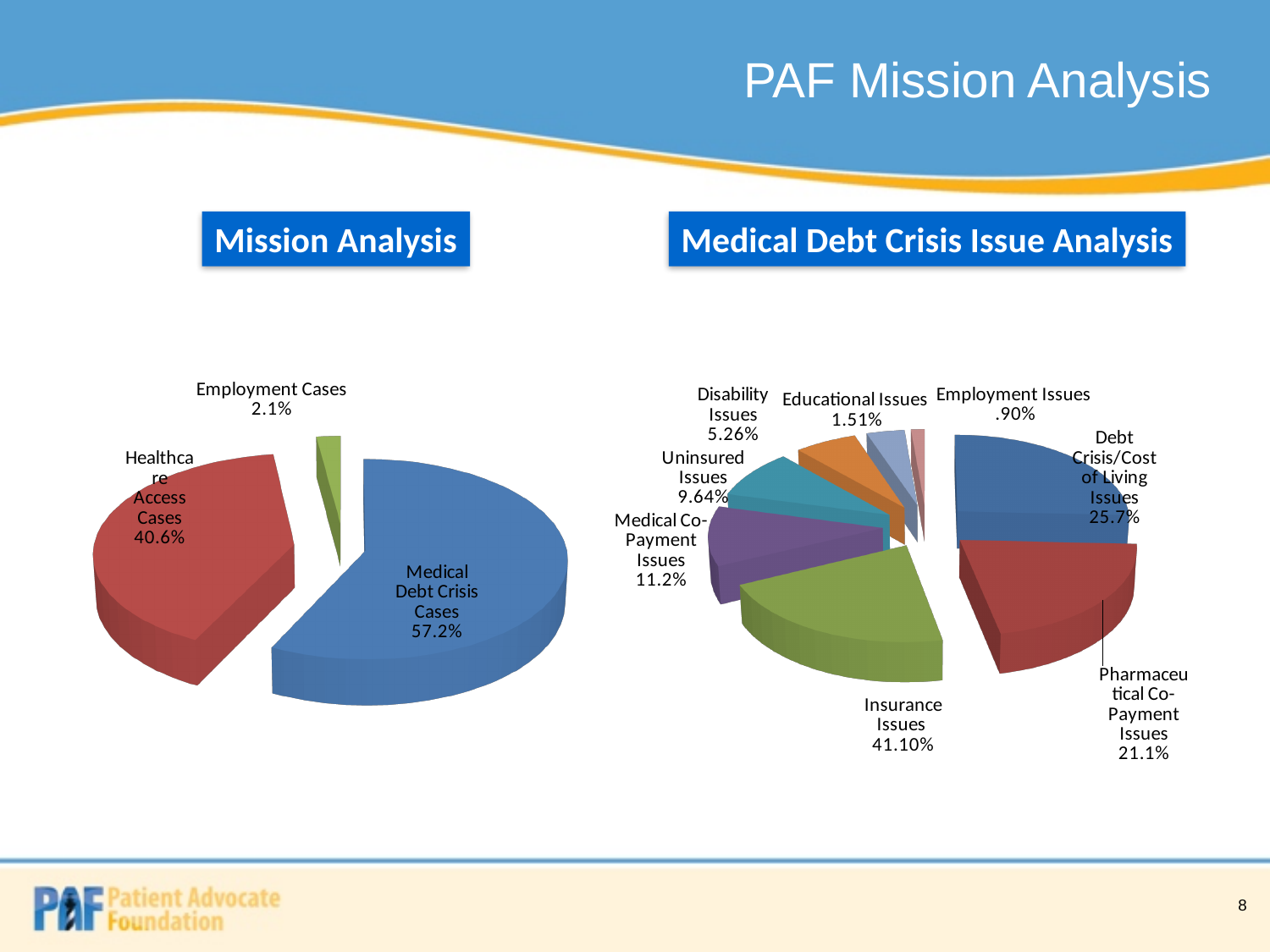
In the Medical Debt Crisis Issue Analysis chart, which is larger: Debt Crisis/Cost of Living Issues or Pharmaceutical Co-Payment Issues? Debt Crisis/Cost of Living Issues In the Medical Debt Crisis Issue Analysis chart, which category has the smallest share? Employment Issues In the Mission Analysis chart, what is the difference between the Medical Debt Crisis Cases share and the Healthcare Access Cases share? 16.6% In the Mission Analysis chart, how many categories are shown? 3 In the Medical Debt Crisis Issue Analysis chart, how many categories are shown? 8 In the Mission Analysis chart, which category has the smallest share? Employment Cases In the Medical Debt Crisis Issue Analysis chart, what share is Uninsured Issues? 9.64% In the Medical Debt Crisis Issue Analysis chart, what share is Insurance Issues? 41.10% In the Mission Analysis chart, what share of cases are Healthcare Access Cases? 40.6% What kind of chart is the Medical Debt Crisis Issue Analysis chart? Pie chart In the Mission Analysis chart, what share of cases are Medical Debt Crisis Cases? 57.2%